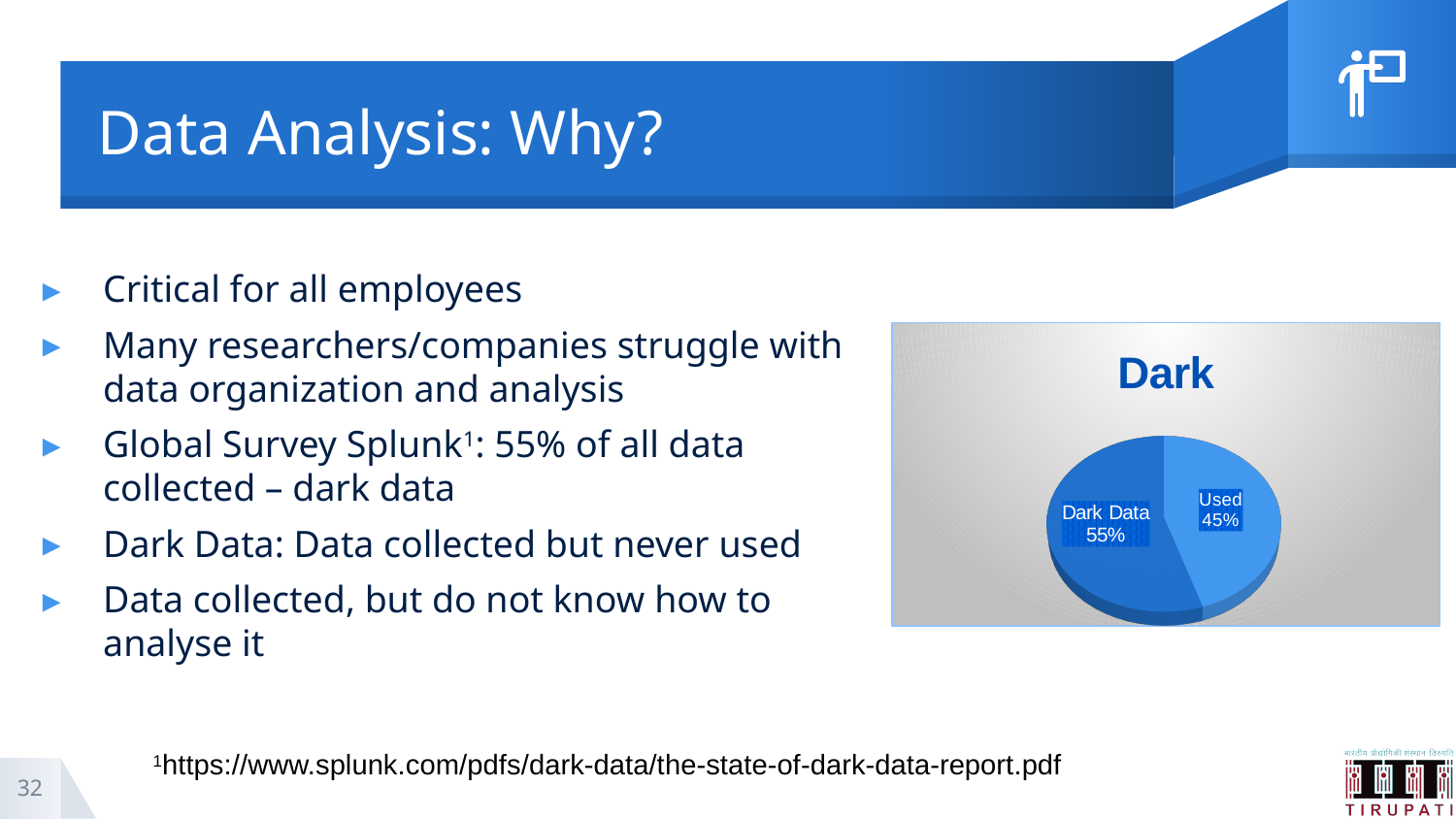
How many slices does the pie chart have? 2 Is the value for Used greater or less than 50%? less Which slice of the pie is the smallest? Used Which is larger, the Dark Data slice or the Used slice? Dark Data What do the two slices of the pie add up to? 100% What share of the pie is labelled Dark Data? 55% What is the difference in percentage points between the Dark Data slice and the Used slice? 10% Is the value for Dark Data greater or less than 50%? greater What is the title of the chart? Dark What kind of chart is shown on the slide? Pie chart Which slice of the pie is the largest? Dark Data What share of the pie is labelled Used? 45%